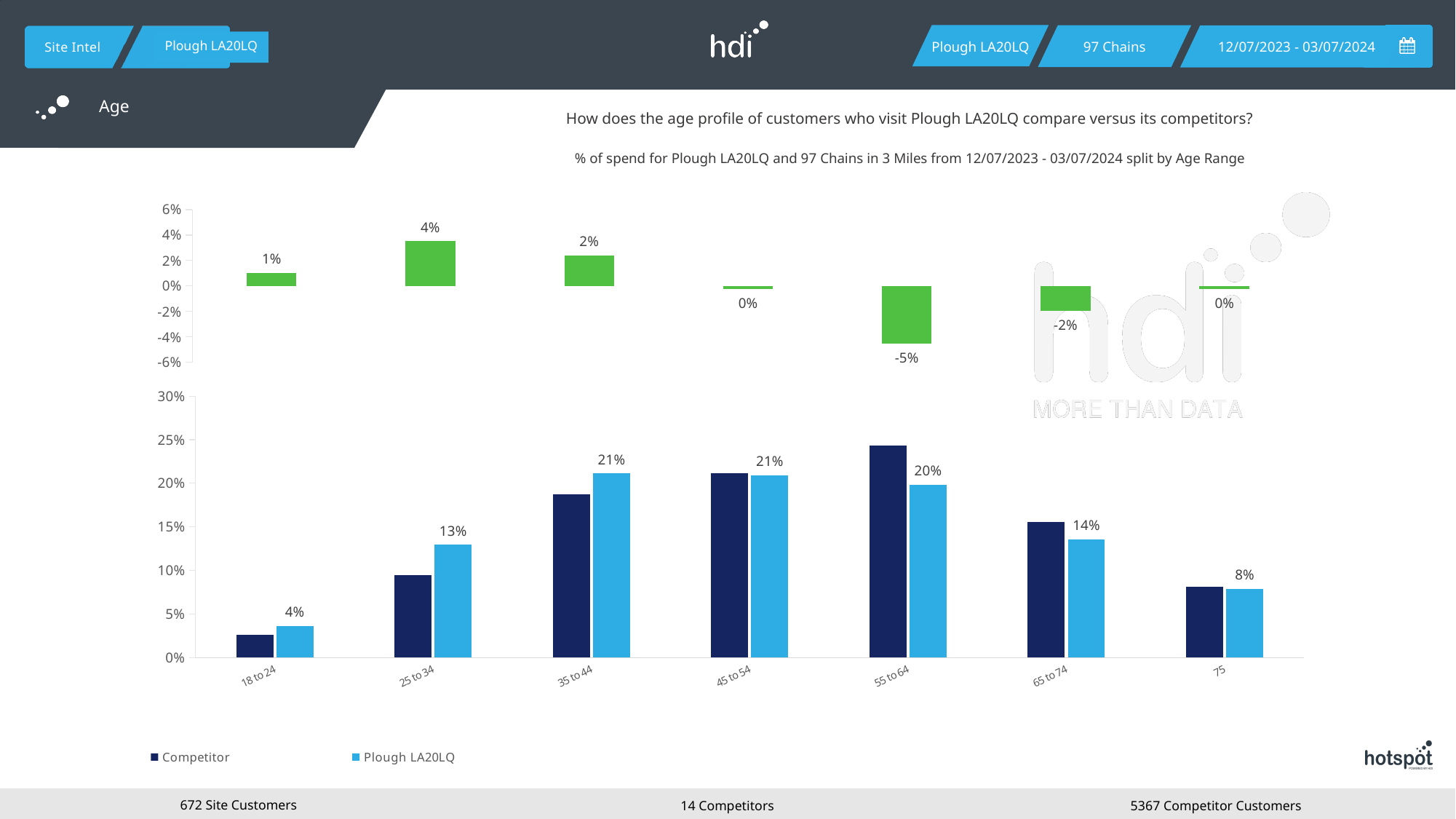
How many series does the legend of the bottom chart list? 2 In the top chart of green bars, which age range has the lowest value? 55 to 64 In the bottom bar chart, which age range has the lowest value for Plough LA20LQ? 18 to 24 How many age range categories are shown on the x axis of the bottom bar chart? 7 In the bottom bar chart, what is the difference between the Plough LA20LQ values for 35 to 44 and 18 to 24? 17 percentage points In the top chart of green bars, what is the value for the 65 to 74 age range? -2% In the bottom bar chart, what is the value for Plough LA20LQ in the 55 to 64 age range? 20% In the bottom bar chart, is the Competitor value for 18 to 24 greater or less than 5%? less In the bottom bar chart, is the Competitor value for 55 to 64 greater or less than 20%? greater In the top chart of green bars, which age range has the highest value? 25 to 34 In the bottom bar chart, for the 55 to 64 age range, which series has the larger value: Competitor or Plough LA20LQ? Competitor In the bottom bar chart, what is the value for Plough LA20LQ in the 25 to 34 age range? 13%